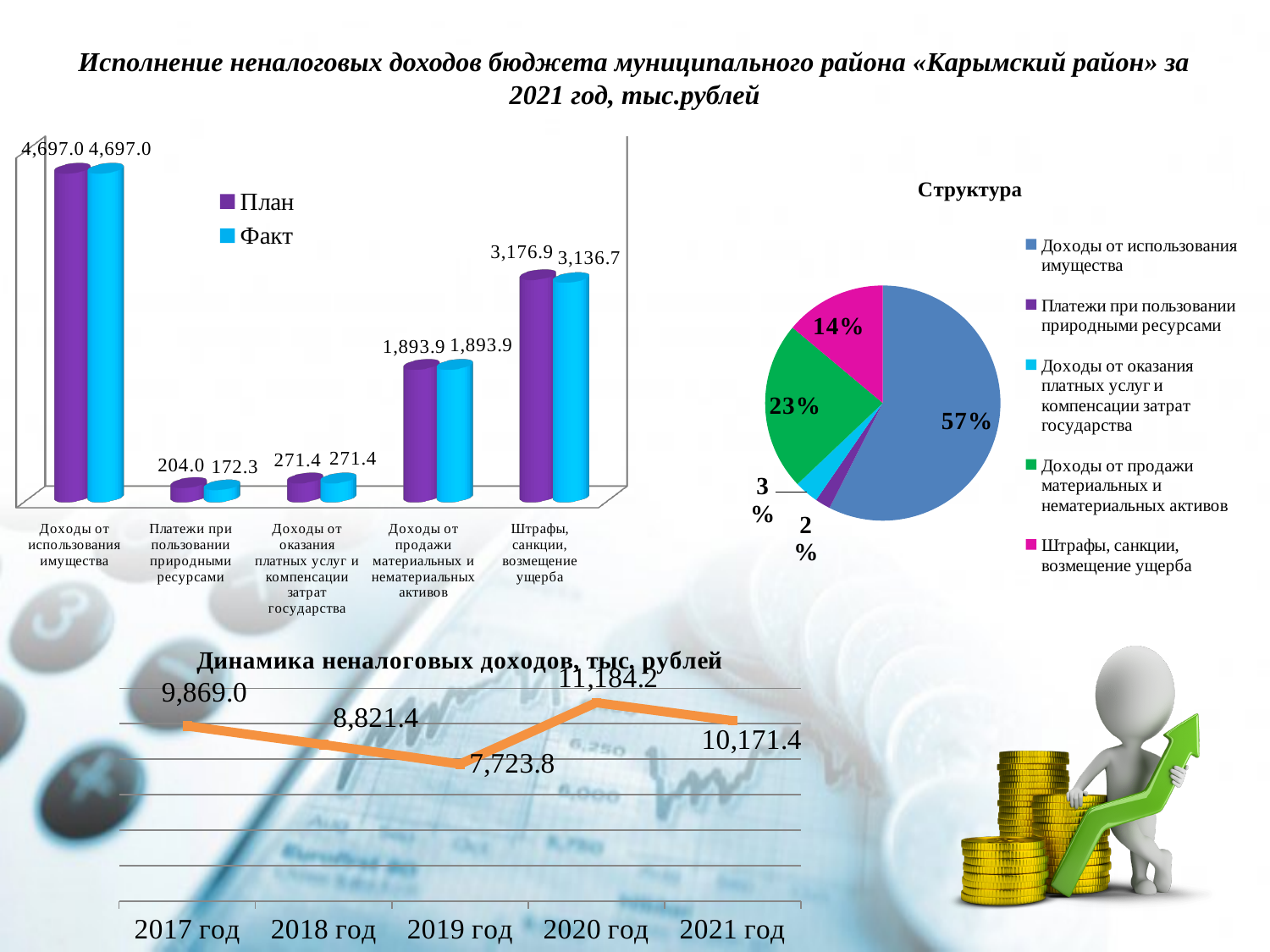
In the pie chart titled Структура, which category has the largest slice? Доходы от использования имущества In the chart titled Динамика неналоговых доходов, тыс. рублей, which year has the lowest value? 2019 год What kind of chart is the one titled Динамика неналоговых доходов, тыс. рублей? line chart In the top-left bar chart, how many series does the legend list? 2 In the top-left bar chart, how many categories are shown? 5 In the pie chart titled Структура, what share does Доходы от продажи материальных и нематериальных активов have? 23% In the pie chart titled Структура, what share does Штрафы, санкции, возмещение ущерба have? 14% In the top-left bar chart, what is the Факт value for Штрафы, санкции, возмещение ущерба? 3,136.7 In the top-left bar chart, what is the difference between the План and Факт values for Платежи при пользовании природными ресурсами? 31.7 In the top-left bar chart, what is the План value for Платежи при пользовании природными ресурсами? 204.0 In the top-left bar chart, which category has the highest Факт value? Доходы от использования имущества In the chart titled Динамика неналоговых доходов, тыс. рублей, what is the value for 2020 год? 11,184.2